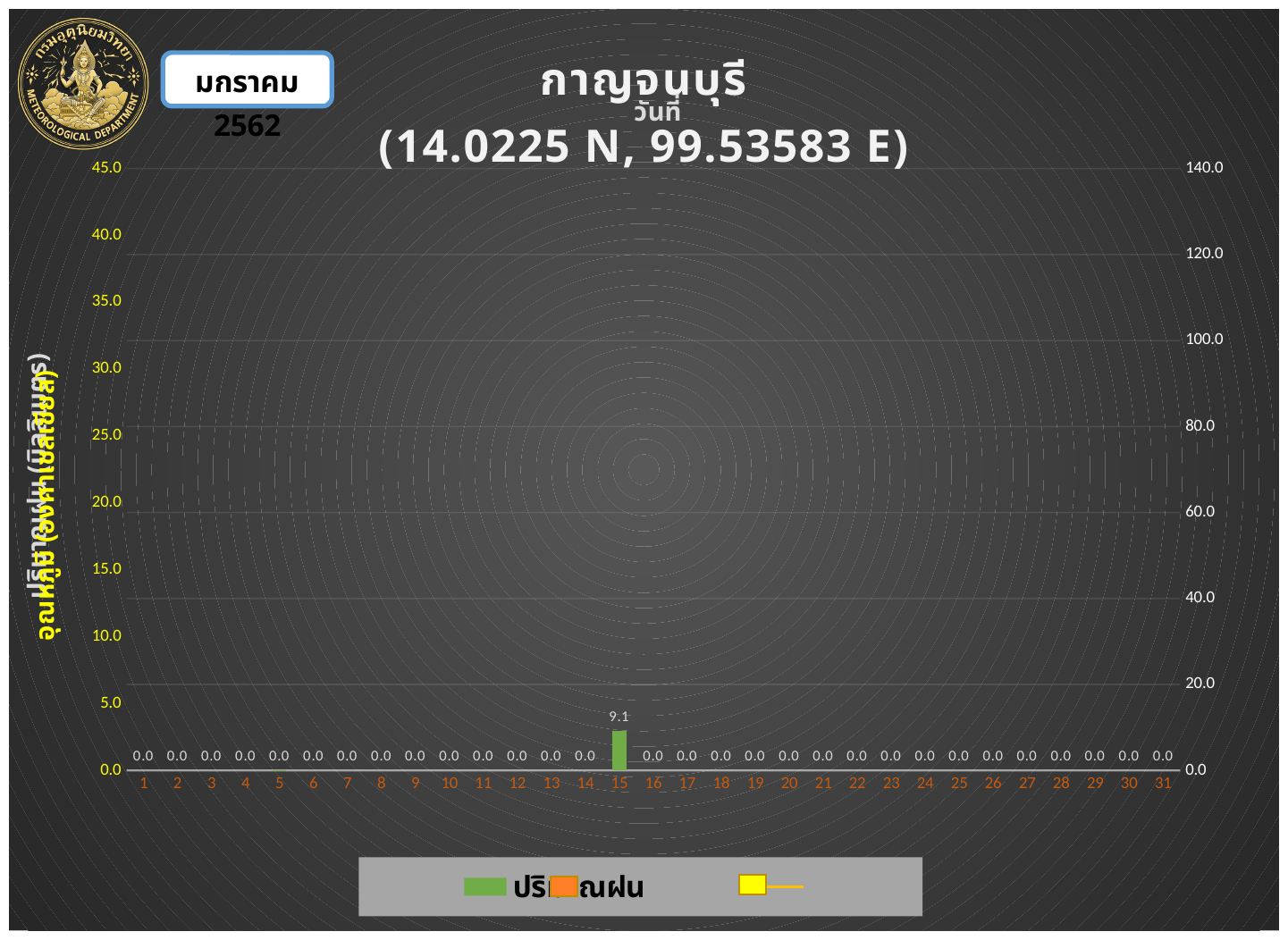
What is the value shown for day 31? 0.0 Which is larger, the value for day 15 or the value for day 20? day 15 What is the difference between the value for day 15 and the value for day 16? 9.1 What is the value shown for day 1? 0.0 What is the highest tick value on the left vertical axis? 45.0 Which day has the highest value on the chart? 15 What kind of chart is shown on the slide? bar chart What is the value shown for day 10? 0.0 What is the highest tick value on the right vertical axis? 140.0 Is the value for day 15 greater or less than 10.0 on the left axis? less What is the rainfall value shown for day 15? 9.1 How many days are shown on the x axis? 31